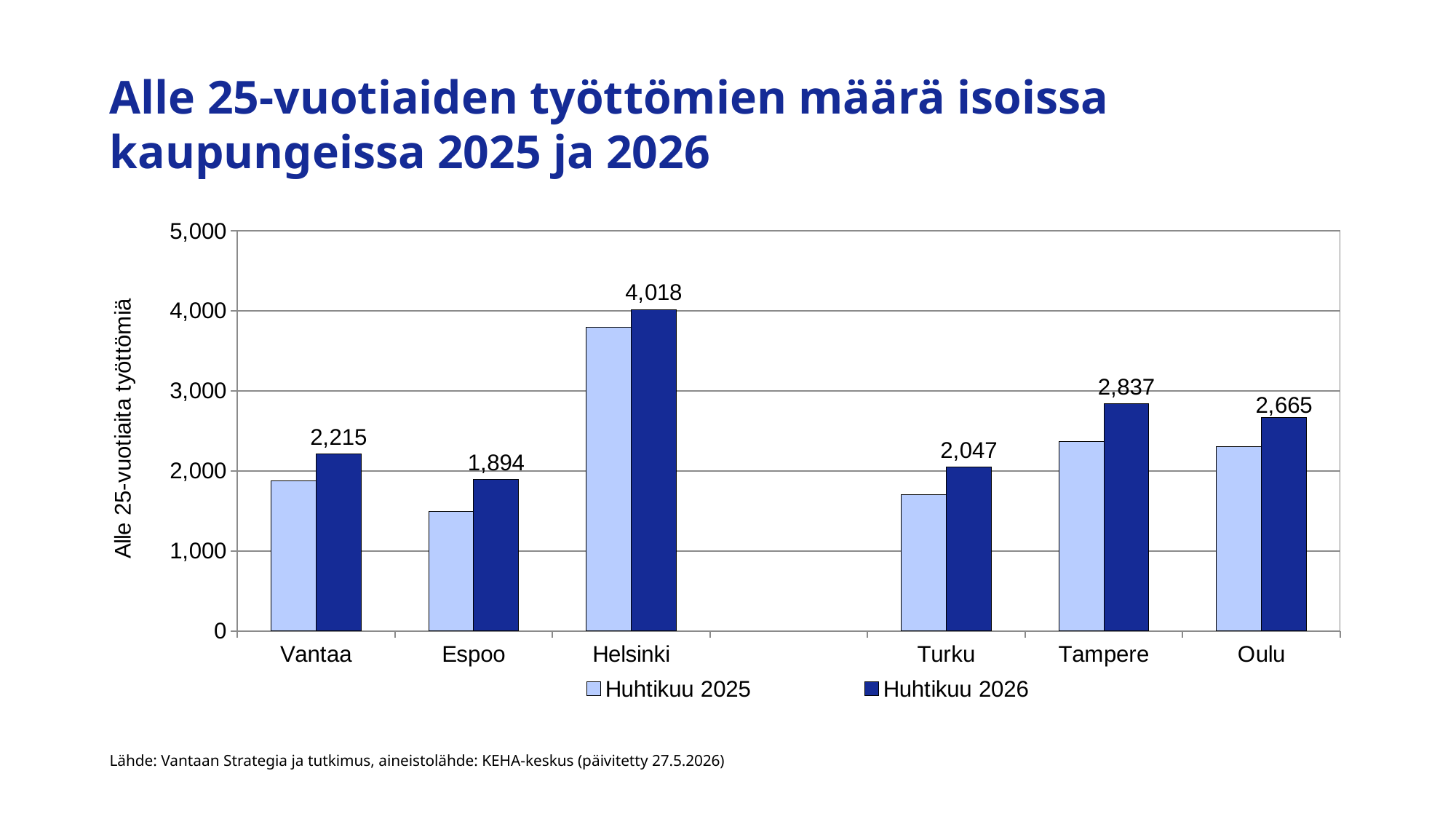
In the Huhtikuu 2026 series, which is larger: Vantaa or Turku? Vantaa How many cities are shown on the x axis? 6 What is the difference between the Huhtikuu 2026 values for Tampere and Oulu? 172 What kind of chart is shown on the slide? bar chart Is the Huhtikuu 2025 value for Espoo greater or less than 2,000? less How many series does the legend list? 2 What is the value for Tampere in the Huhtikuu 2026 series? 2,837 Is the Huhtikuu 2025 value for Helsinki greater or less than 3,000? greater Which city has the highest value in the Huhtikuu 2026 series? Helsinki What is the value for Espoo in the Huhtikuu 2026 series? 1,894 What is the value for Helsinki in the Huhtikuu 2026 series? 4,018 Which city has the lowest value in the Huhtikuu 2026 series? Espoo